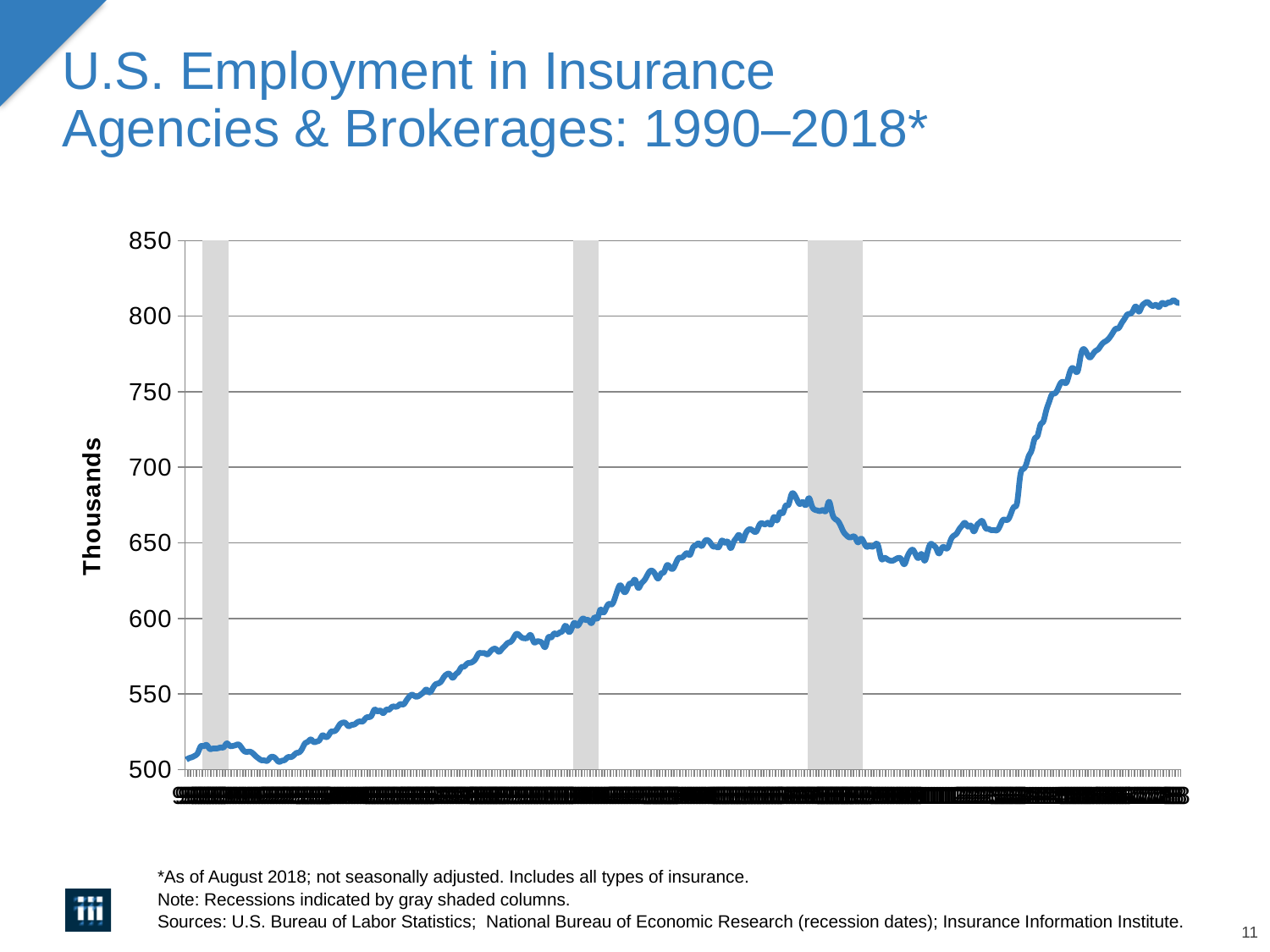
Is the lowest point of the line after the third gray shaded column greater or less than 600? greater What is the highest value shown on the vertical axis of the chart? 850 Overall, do the values rise or fall from the left end of the chart to the right end? rise What is the label on the vertical axis of the chart? Thousands Is the peak reached just before the third gray shaded column greater or less than 700? less What is the title of the chart on the slide? U.S. Employment in Insurance Agencies & Brokerages: 1990–2018* What kind of chart is shown on the slide? line chart Is the value at the right end of the line (end of the series) greater or less than 750? greater Does the line rise or fall during the third gray shaded (recession) column? fall